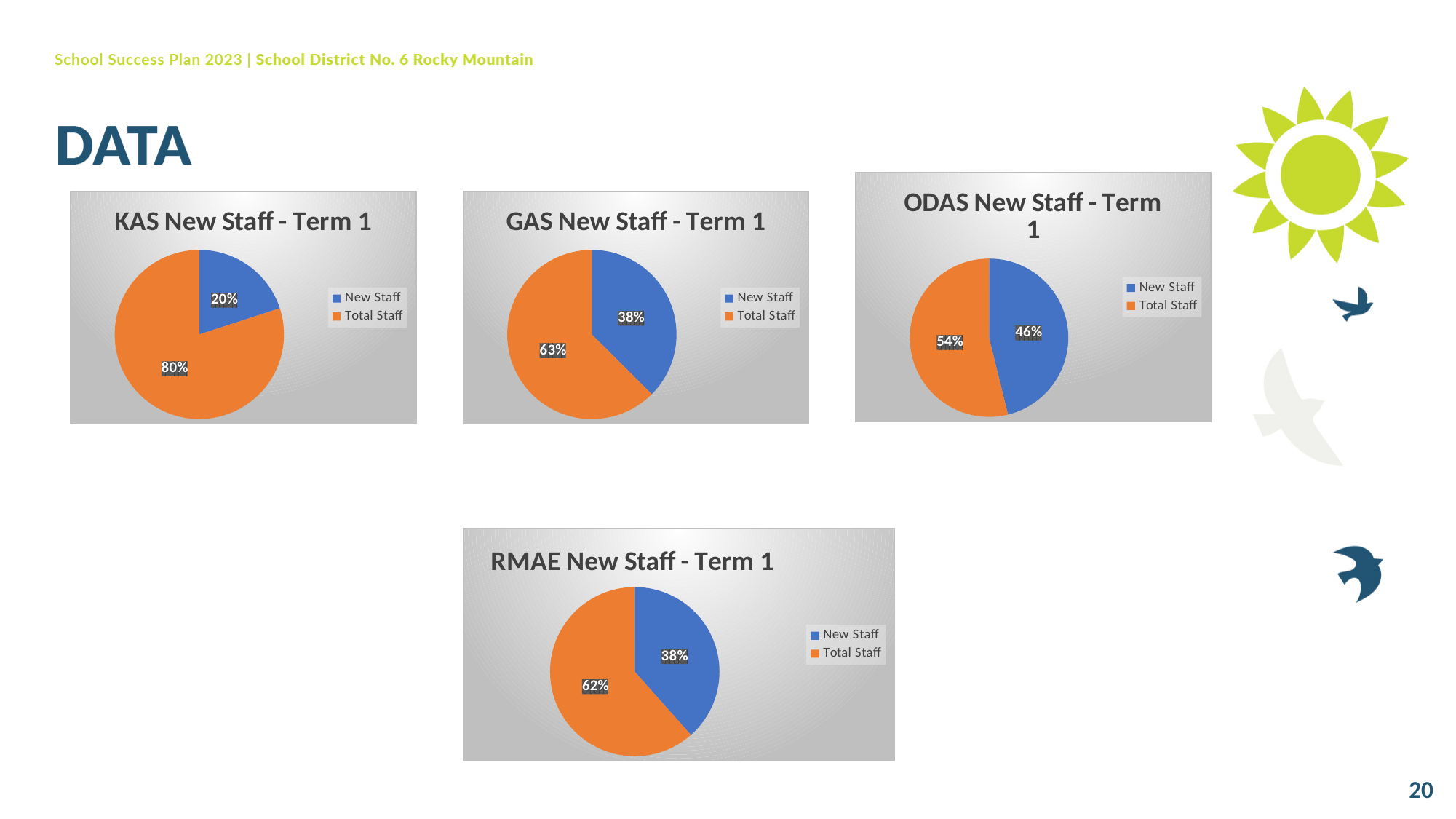
In the 'RMAE New Staff - Term 1' chart, what percentage is shown for Total Staff? 62% In the 'KAS New Staff - Term 1' chart, what percentage is shown for New Staff? 20% In the 'GAS New Staff - Term 1' chart, what percentage is shown for New Staff? 38% What kind of chart is 'ODAS New Staff - Term 1'? Pie chart In the 'RMAE New Staff - Term 1' chart, which slice is larger, New Staff or Total Staff? Total Staff In the 'KAS New Staff - Term 1' chart, what percentage is shown for Total Staff? 80% In the 'GAS New Staff - Term 1' chart, what percentage is shown for Total Staff? 63% How many slices does the 'GAS New Staff - Term 1' pie chart have? 2 In the 'ODAS New Staff - Term 1' chart, what percentage is shown for Total Staff? 54% In the 'RMAE New Staff - Term 1' chart, what colour is the New Staff slice? Blue In the 'ODAS New Staff - Term 1' chart, what percentage is shown for New Staff? 46% In the 'KAS New Staff - Term 1' chart, what is the difference between the Total Staff and New Staff percentages? 60%